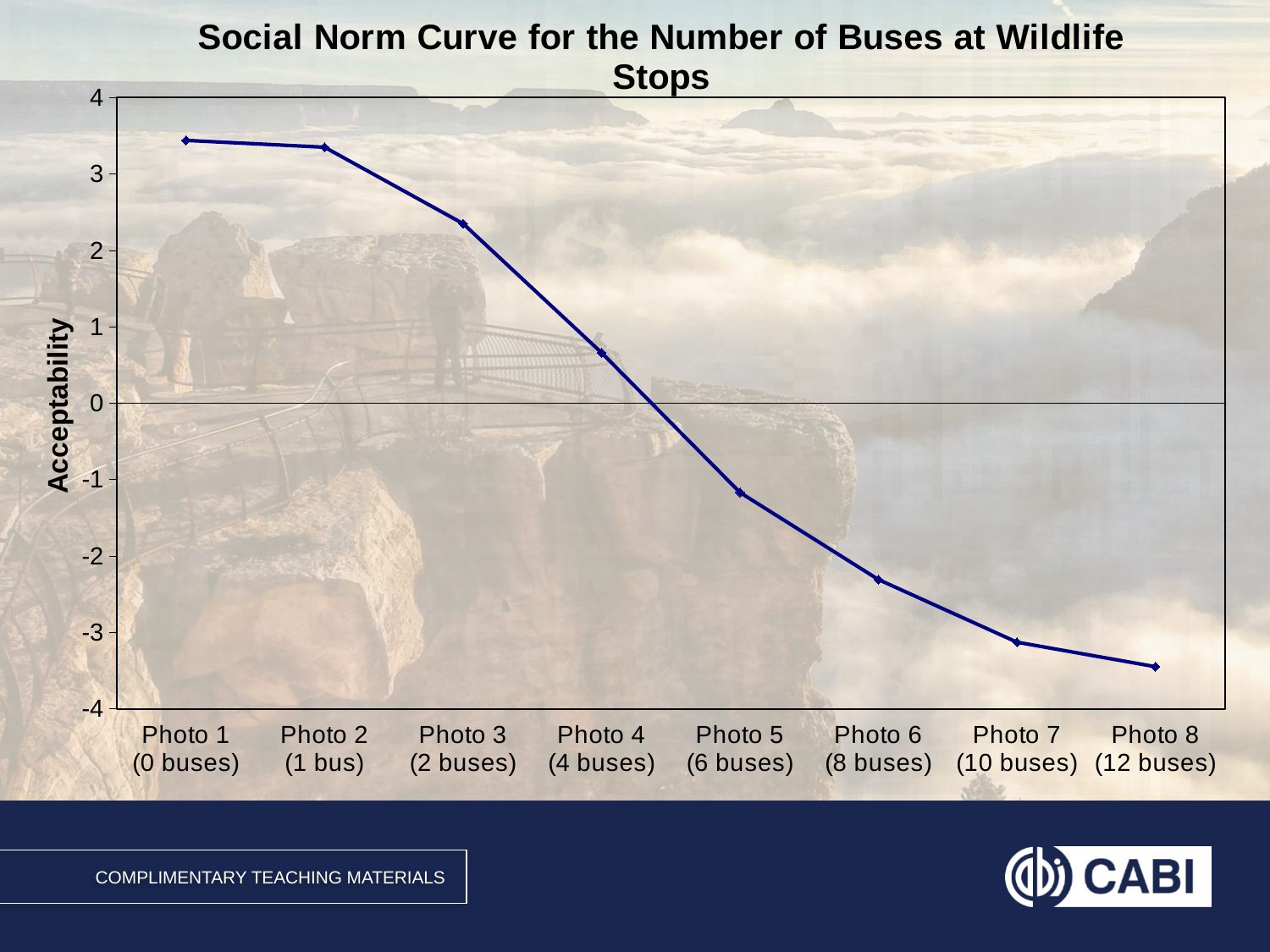
Which has the higher acceptability value, Photo 2 (1 bus) or Photo 4 (4 buses)? Photo 2 (1 bus) How many photo categories are plotted along the x axis? 8 Which photo has the lowest acceptability value? Photo 8 (12 buses) Is the acceptability value for Photo 7 (10 buses) greater or less than -3? less Is the acceptability value for Photo 1 (0 buses) greater or less than 3? greater Is the acceptability value for Photo 6 (8 buses) greater or less than -2? less What is the label on the vertical axis of the chart? Acceptability What kind of chart is shown on the slide? line chart Do the acceptability values rise or fall as the number of buses increases from Photo 1 to Photo 8? fall